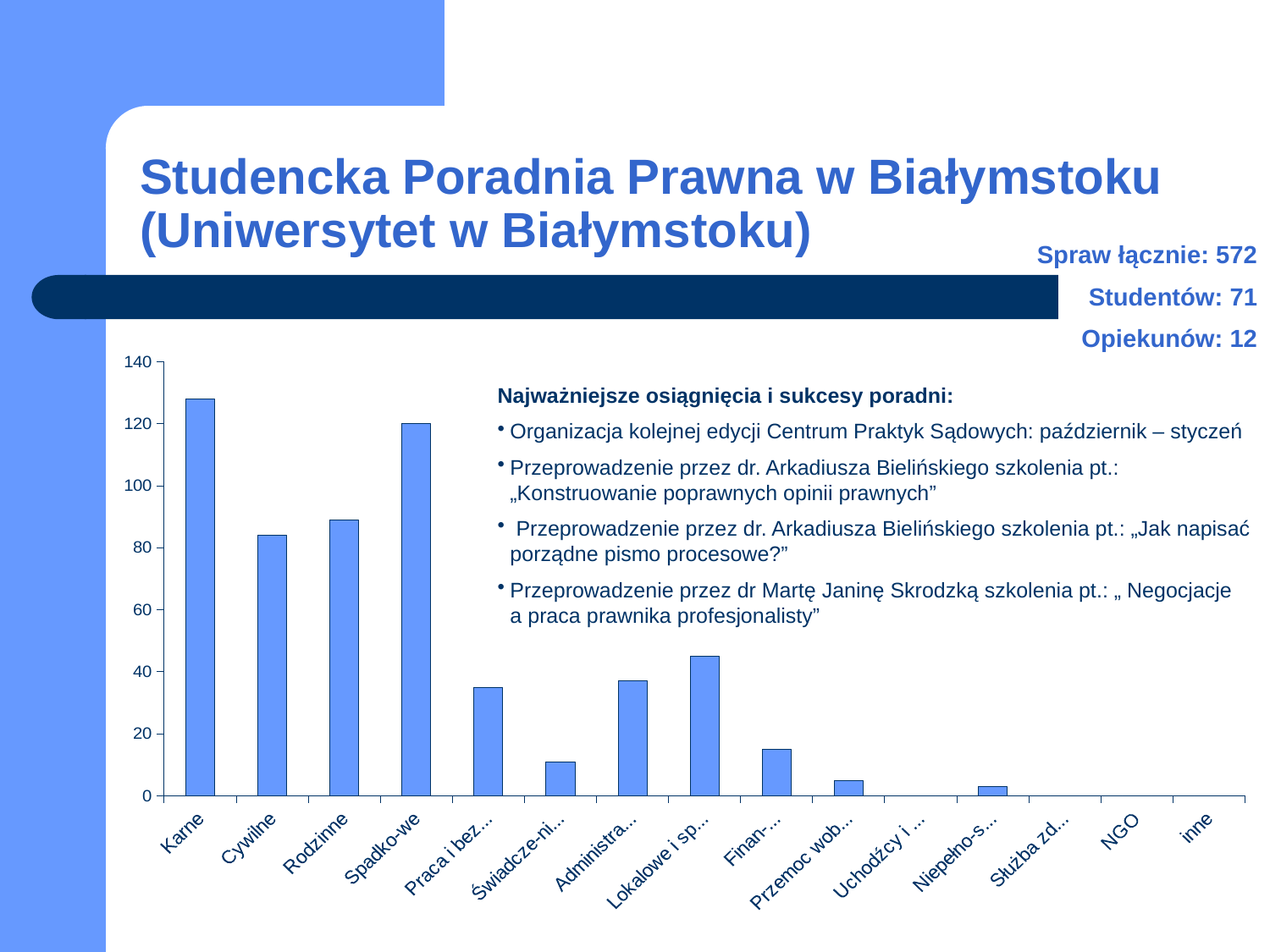
Is the value for Cywilne greater or less than 80? greater Is the value for Praca i bez... greater or less than 40? less Is the value for Karne greater or less than 120? greater Which is larger, the value for Spadko-we or the value for Rodzinne? Spadko-we Which is larger, the value for Karne or the value for Cywilne? Karne Which category has the highest bar in the chart? Karne What colour are the bars in the chart? blue How many categories are shown on the x axis of the chart? 15 What kind of chart is shown on the slide? bar chart